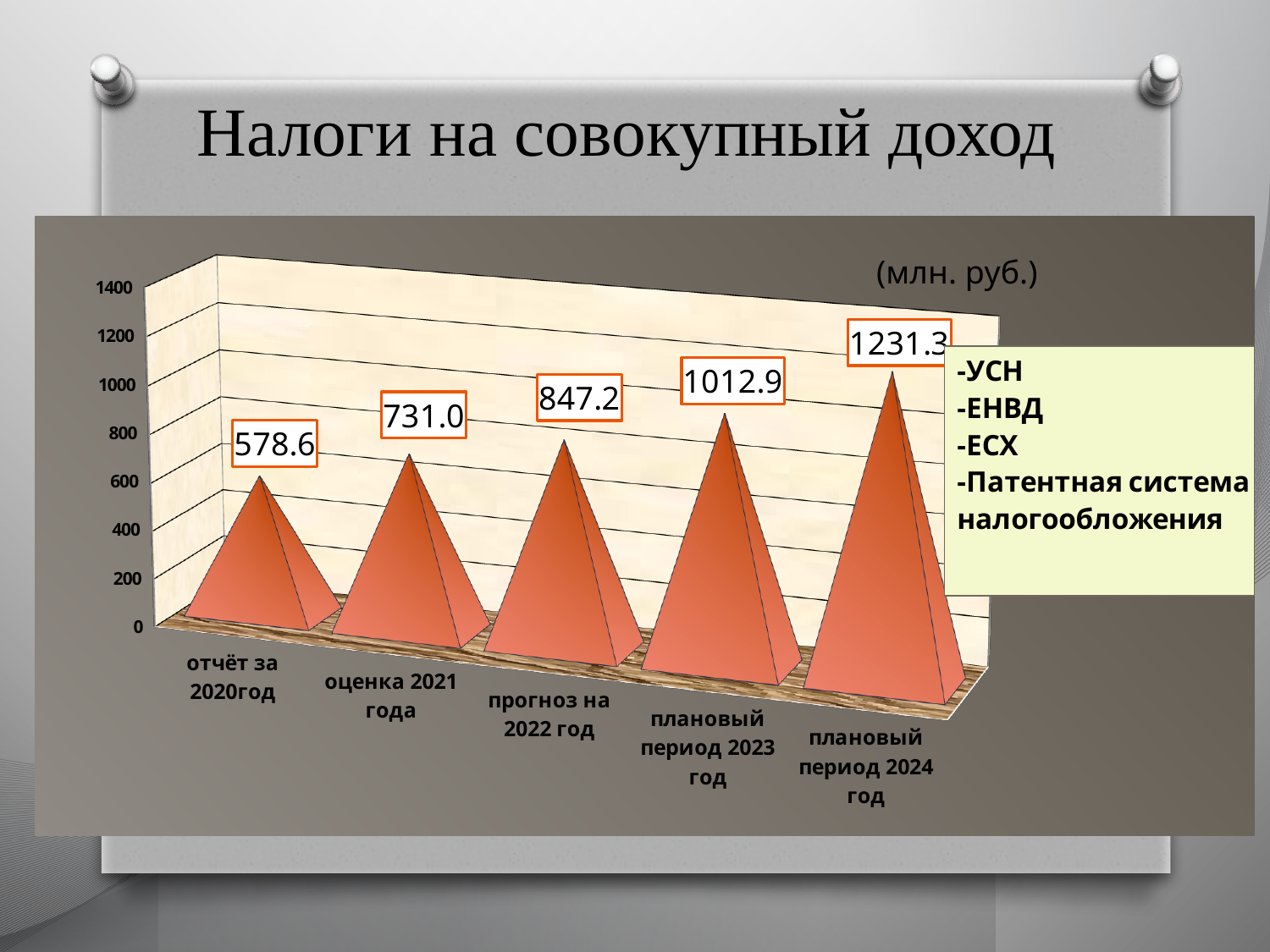
What is the difference between the values for 'плановый период 2023 год' and 'прогноз на 2022 год'? 165.7 What is the value for 'оценка 2021 года'? 731.0 Do the values rise or fall from left to right along the x axis? rise What is the value for 'отчёт за 2020год'? 578.6 Which category has the highest value? плановый период 2024 год What is the value for 'прогноз на 2022 год'? 847.2 Which category has the lowest value? отчёт за 2020год Is the value for 'плановый период 2023 год' greater or less than 1000? greater Which is larger, the value for 'оценка 2021 года' or the value for 'отчёт за 2020год'? оценка 2021 года What unit is shown on the chart? млн. руб. What is the value for 'плановый период 2024 год'? 1231.3 How many categories are shown on the chart? 5